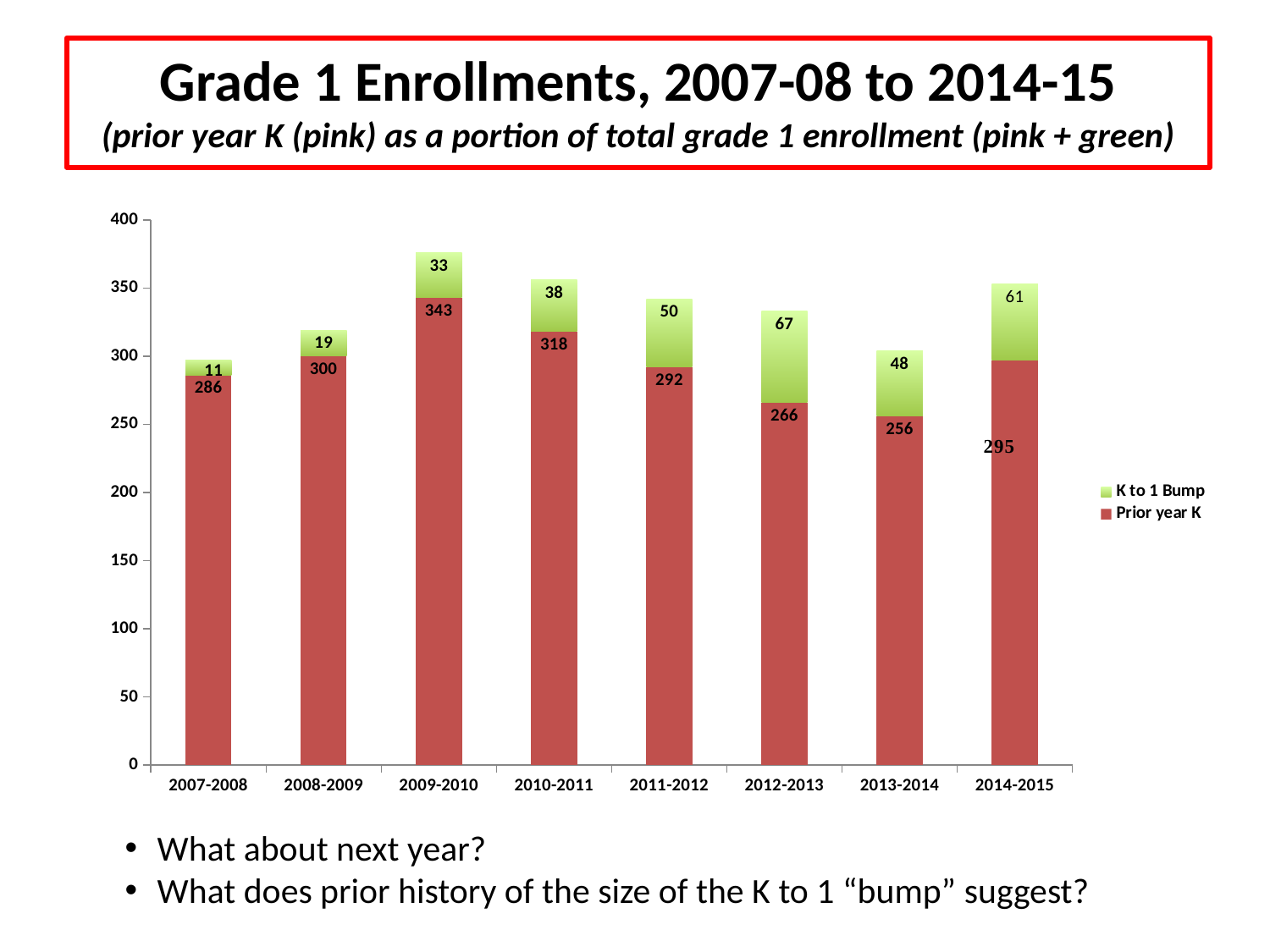
What is the Prior year K value for 2014-2015? 295 What kind of chart is shown on the slide? Stacked bar chart How many series does the legend list? 2 What is the Prior year K value for 2009-2010? 343 What is the difference between the K to 1 Bump values for 2012-2013 and 2007-2008? 56 Which year has the lowest Prior year K value? 2013-2014 What is the total grade 1 enrollment (Prior year K plus K to 1 Bump) for 2009-2010? 376 Which year has the highest Prior year K value? 2009-2010 Which is larger, the Prior year K value for 2010-2011 or for 2011-2012? 2010-2011 Which year has the lowest K to 1 Bump value? 2007-2008 How many school years are shown on the x axis? 8 What is the K to 1 Bump value for 2012-2013? 67